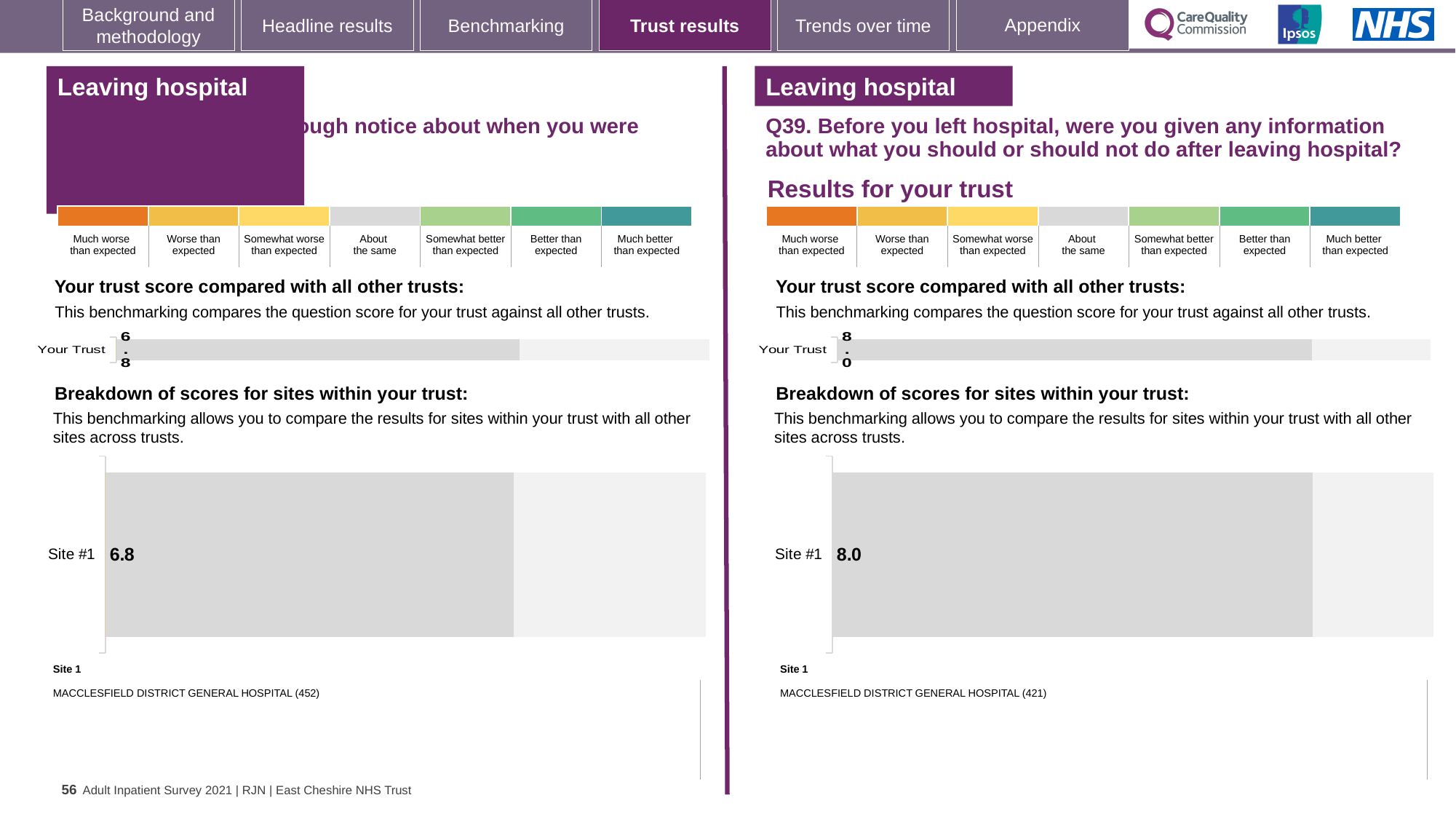
What kind of chart is used to show the Site #1 score in the right panel (Q39)? Bar chart Which panel shows the higher Site #1 score, the left panel or the right panel (Q39)? The right panel (Q39) In the right panel (Q39), what is the score shown for Your Trust in the 'Your trust score compared with all other trusts' chart? 8.0 What number appears in parentheses after the Site 1 hospital name in the left panel? 452 In the left panel, what score is shown for Site #1 in the breakdown of scores for sites chart? 6.8 What is the difference between the Site #1 score in the right panel (Q39) and the Site #1 score in the left panel? 1.2 In the right panel (Q39), what score is shown for Site #1 in the breakdown of scores for sites chart? 8.0 In the left panel, what is the score shown for Your Trust in the 'Your trust score compared with all other trusts' chart? 6.8 How many sites are shown in the breakdown of scores for sites chart in the right panel (Q39)? 1 Which hospital is listed as Site 1 below the breakdown chart in the right panel (Q39)? MACCLESFIELD DISTRICT GENERAL HOSPITAL In the left panel, is the Site #1 score greater or less than the Your Trust score, or are they equal? Equal